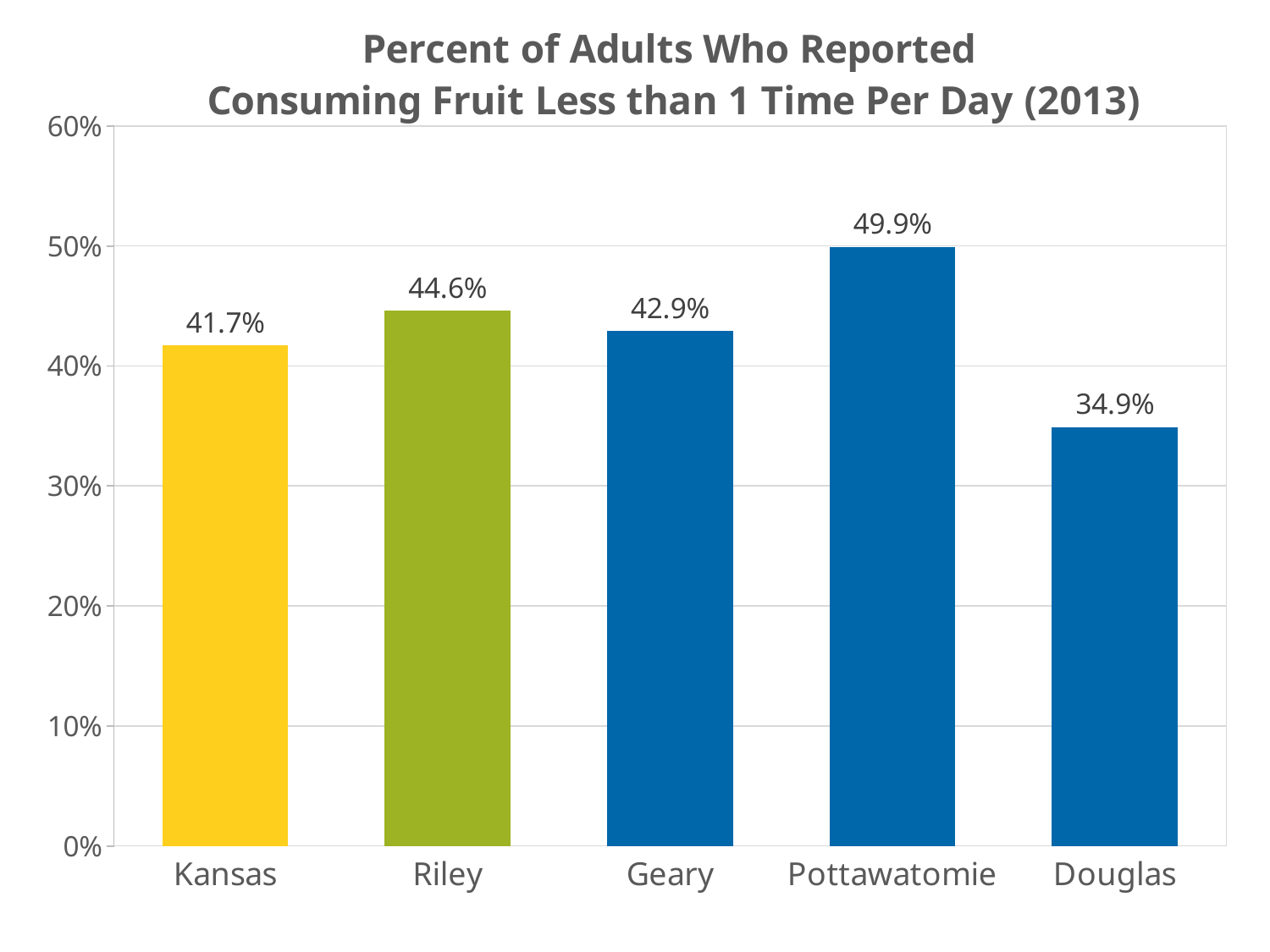
What is the value for Douglas? 34.9% What is the difference between the values for Pottawatomie and Douglas? 15.0% What kind of chart is this? bar chart Which is larger, the value for Riley or the value for Geary? Riley Is the value for Douglas greater or less than 40%? less What is the difference between the values for Riley and Kansas? 2.9% What is the value for Kansas? 41.7% Which category has the lowest value? Douglas What is the value for Pottawatomie? 49.9% Which category has the highest value? Pottawatomie What is the title of the chart? Percent of Adults Who Reported Consuming Fruit Less than 1 Time Per Day (2013) How many categories are shown on the x axis? 5